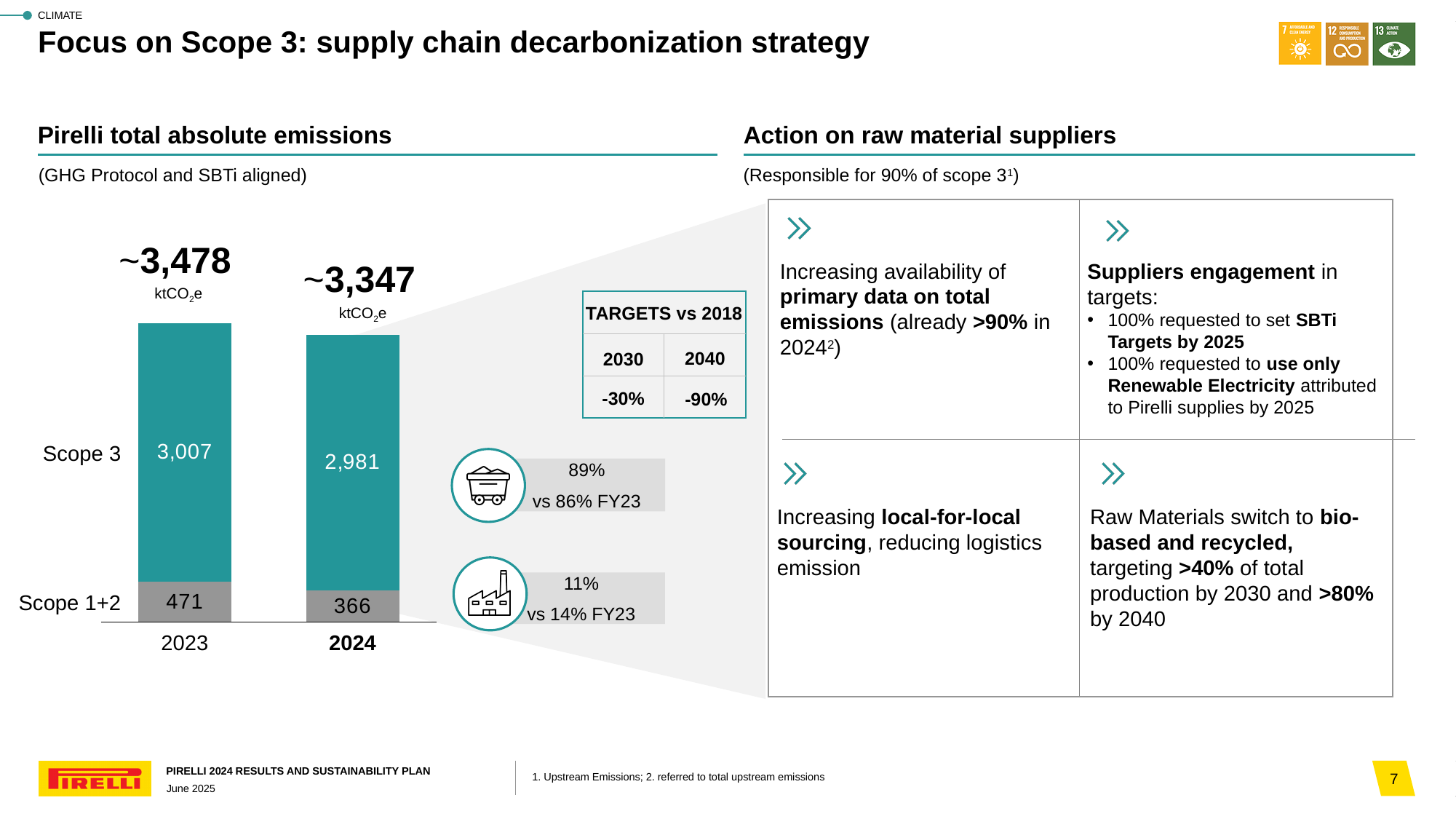
By how much did Scope 1+2 emissions change from 2023 to 2024? 105 What is the total emissions figure shown above the 2023 bar? ~3,478 What is the Scope 3 value for 2023 in the Pirelli total absolute emissions chart? 3,007 How many years are shown on the x axis of the emissions chart? 2 Which year has the larger Scope 1+2 value, 2023 or 2024? 2023 What is the Scope 3 value for 2024 in the Pirelli total absolute emissions chart? 2,981 What is the Scope 1+2 value for 2024 in the Pirelli total absolute emissions chart? 366 What is the total emissions figure shown above the 2024 bar? ~3,347 What is the Scope 1+2 value for 2023 in the Pirelli total absolute emissions chart? 471 Do total emissions rise or fall from 2023 to 2024? fall What type of chart is used to show Pirelli total absolute emissions? stacked bar chart By how much did Scope 3 emissions change from 2023 to 2024? 26